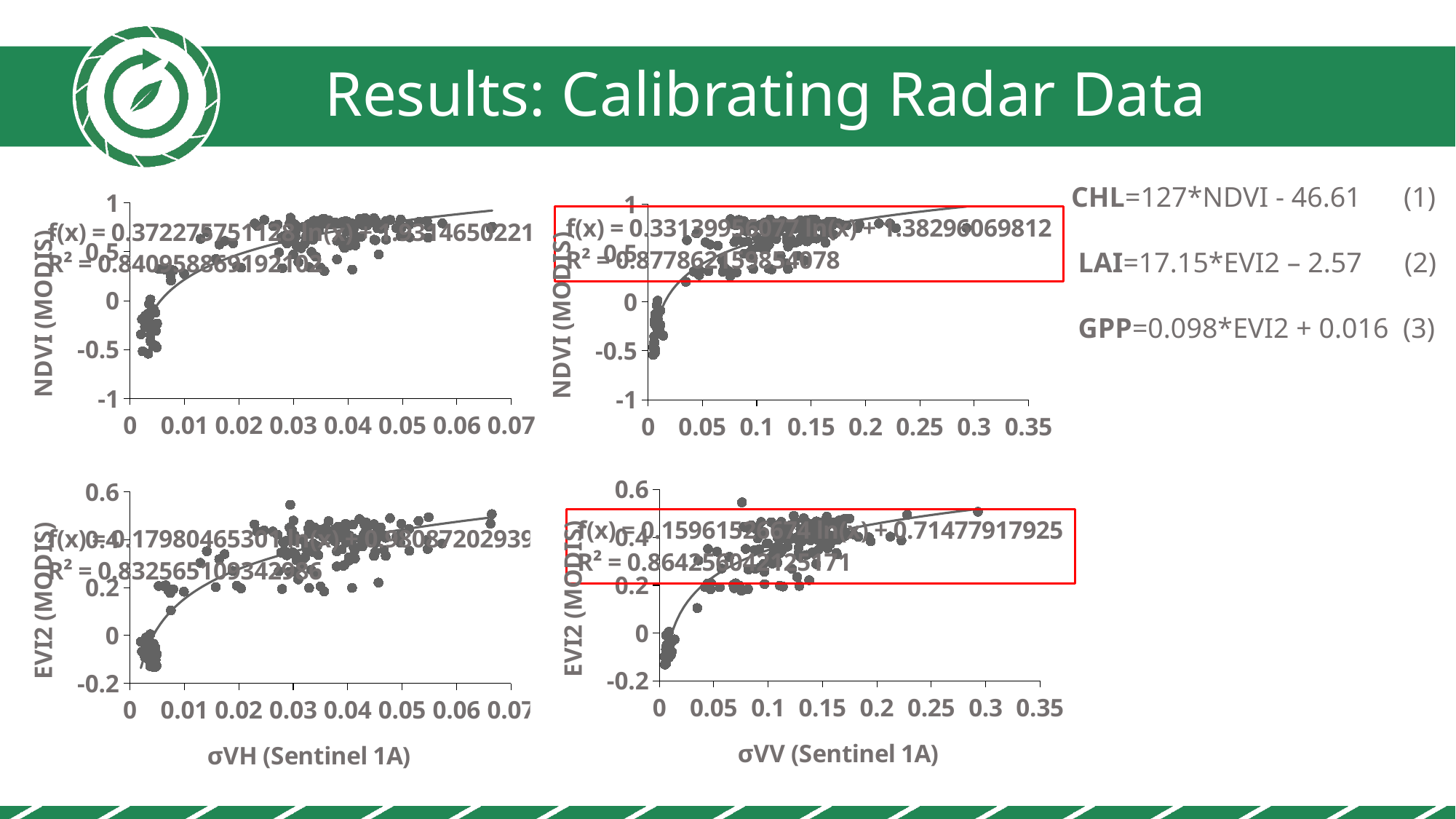
What is the highest tick value shown on the x axis of the top-right chart (NDVI vs σVV)? 0.35 In the bottom-right chart (EVI2 vs σVV), are the EVI2 values at σVV near 0.01 greater or less than 0.2? less In the top-left chart (NDVI vs σVH), are the NDVI values at σVH around 0.05 greater or less than 0.5? greater In the top-left chart (NDVI vs σVH), do the NDVI values rise or fall as σVH increases along the x axis? Rise In the bottom-right chart (EVI2 vs σVV), do the EVI2 values rise or fall as σVV increases along the x axis? Rise How many charts are shown on the slide? 4 What kind of chart is the top-left chart (NDVI vs σVH)? Scatter chart In the bottom-right chart, what is the label of the x axis? σVV (Sentinel 1A) In the top-left chart, what is the label of the y axis? NDVI (MODIS) In the top-right chart (NDVI vs σVV), are the NDVI values at σVV around 0.3 greater or less than 0.5? greater